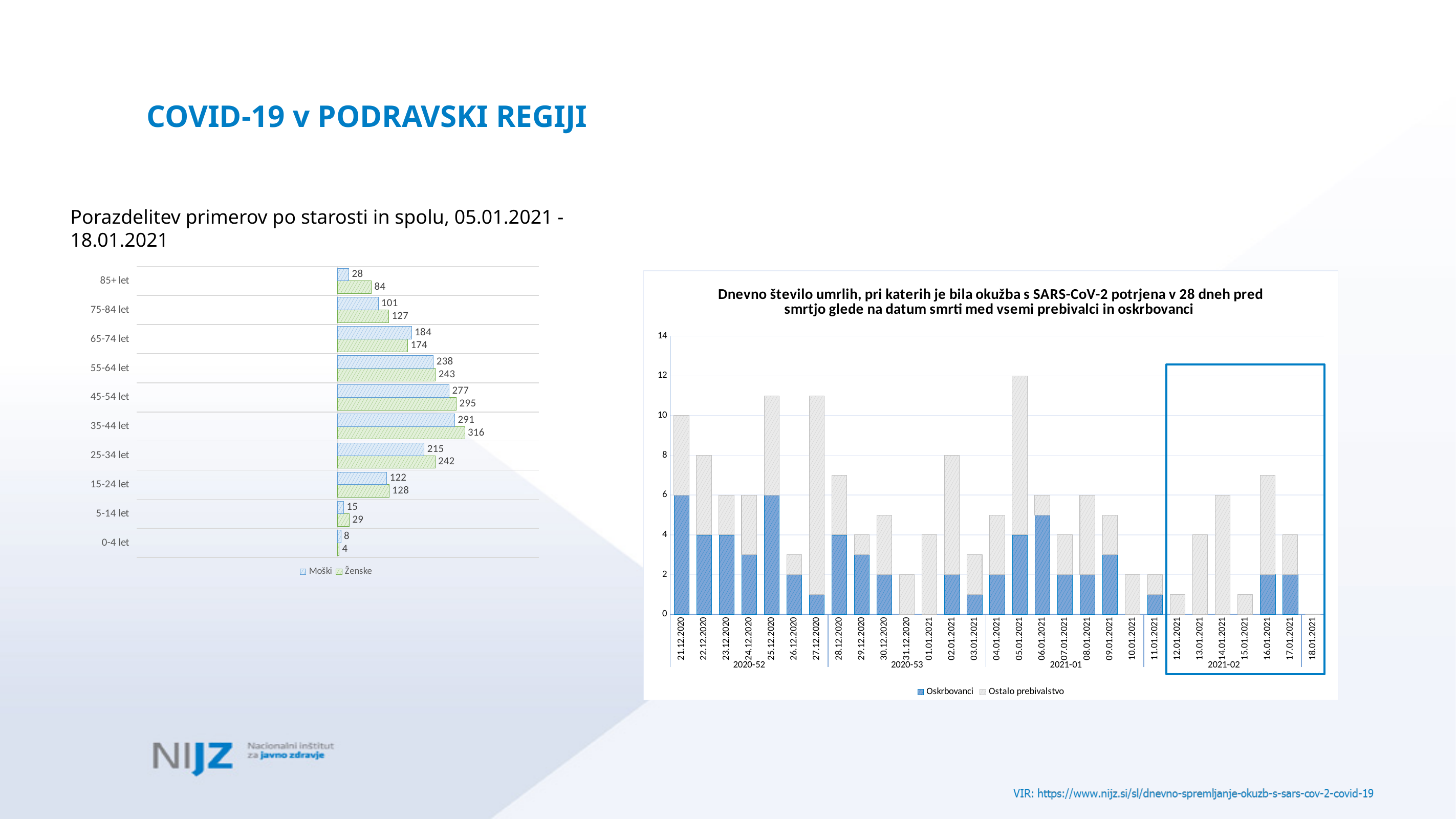
How many age groups are shown in the left chart (Porazdelitev primerov po starosti in spolu)? 10 In the left chart (Porazdelitev primerov po starosti in spolu), which age group has the highest value for Ženske? 35-44 let In the right chart (Dnevno število umrlih), is the total for 25.12.2020 greater or less than 10? greater In the left chart (Porazdelitev primerov po starosti in spolu), what is the value for Ženske in the 85+ let age group? 84 In the left chart (Porazdelitev primerov po starosti in spolu), what is the value for Moški in the 35-44 let age group? 291 In the left chart (Porazdelitev primerov po starosti in spolu), what is the difference between Ženske and Moški in the 45-54 let age group? 18 In the left chart (Porazdelitev primerov po starosti in spolu), which age group has the lowest value for Moški? 0-4 let In the right chart (Dnevno število umrlih), which date has the highest total number of deaths? 05.01.2021 In the right chart (Dnevno število umrlih), what is the value for Oskrbovanci on 21.12.2020? 6 How many series does the legend of the left chart (Porazdelitev primerov po starosti in spolu) list? 2 In the left chart (Porazdelitev primerov po starosti in spolu), which is larger in the 65-74 let age group, Moški or Ženske? Moški What kind of chart is the right chart (Dnevno število umrlih)? Stacked bar chart